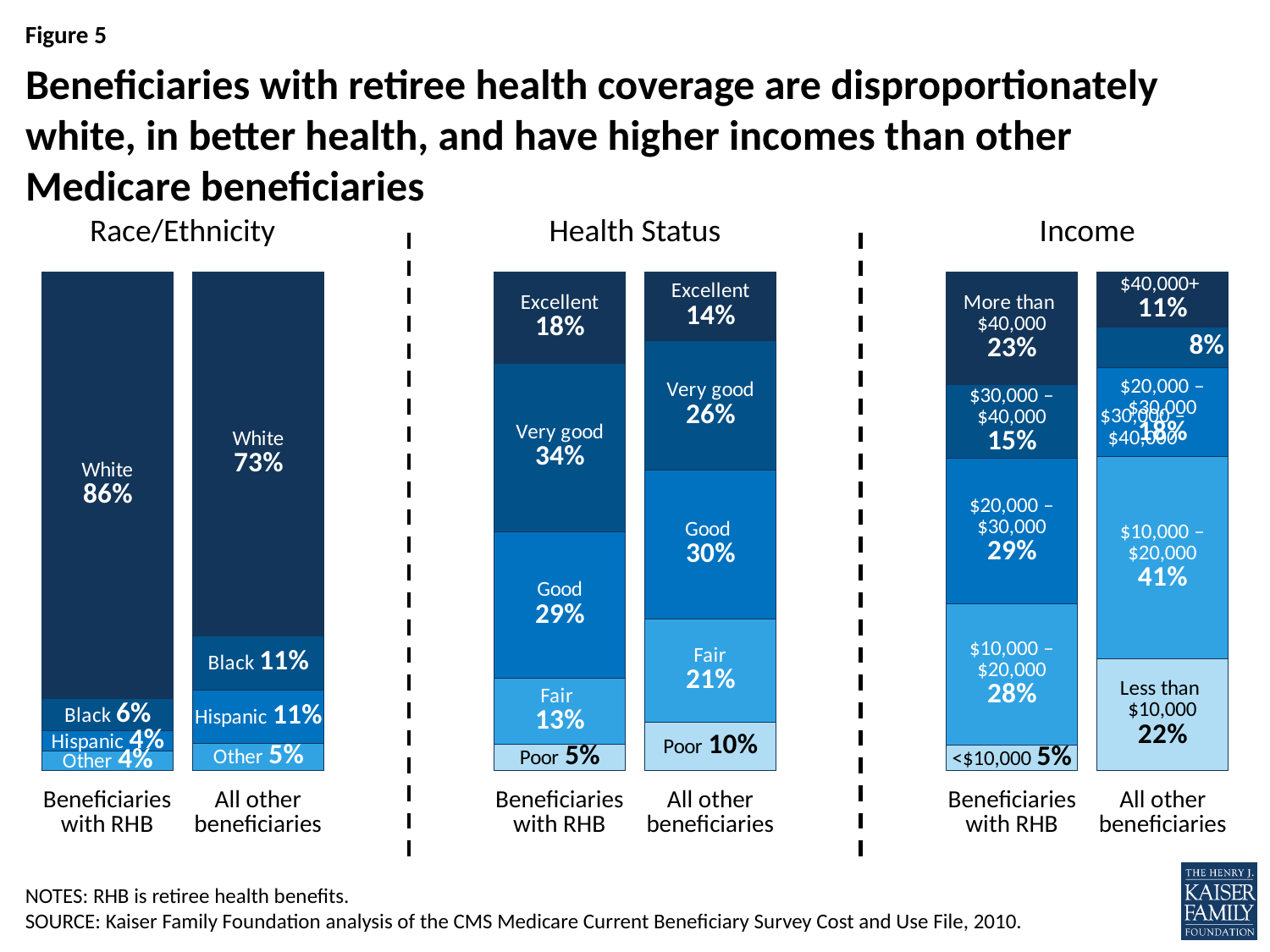
In the Income chart, what share of beneficiaries with RHB have income of more than $40,000? 23% In the Race/Ethnicity chart, what share of all other beneficiaries are Hispanic? 11% In the Health Status chart, what share of beneficiaries with RHB report Very good health? 34% In the Race/Ethnicity chart, what share of beneficiaries with RHB are White? 86% In the Health Status chart, what share of all other beneficiaries report Poor health? 10% In the Health Status chart, is the Fair share larger for beneficiaries with RHB or for all other beneficiaries? All other beneficiaries In the Health Status chart, which health category is the smallest for beneficiaries with RHB? Poor In the Health Status chart, which health category is the largest for all other beneficiaries? Good In the Income chart, what is the difference between the share with income less than $10,000 for all other beneficiaries and for beneficiaries with RHB? 17 percentage points In the Income chart, what share of all other beneficiaries have income of $10,000 to $20,000? 41% What type of chart is used on this slide? Stacked bar chart In the Race/Ethnicity chart, what is the difference between the White share for beneficiaries with RHB and for all other beneficiaries? 13 percentage points